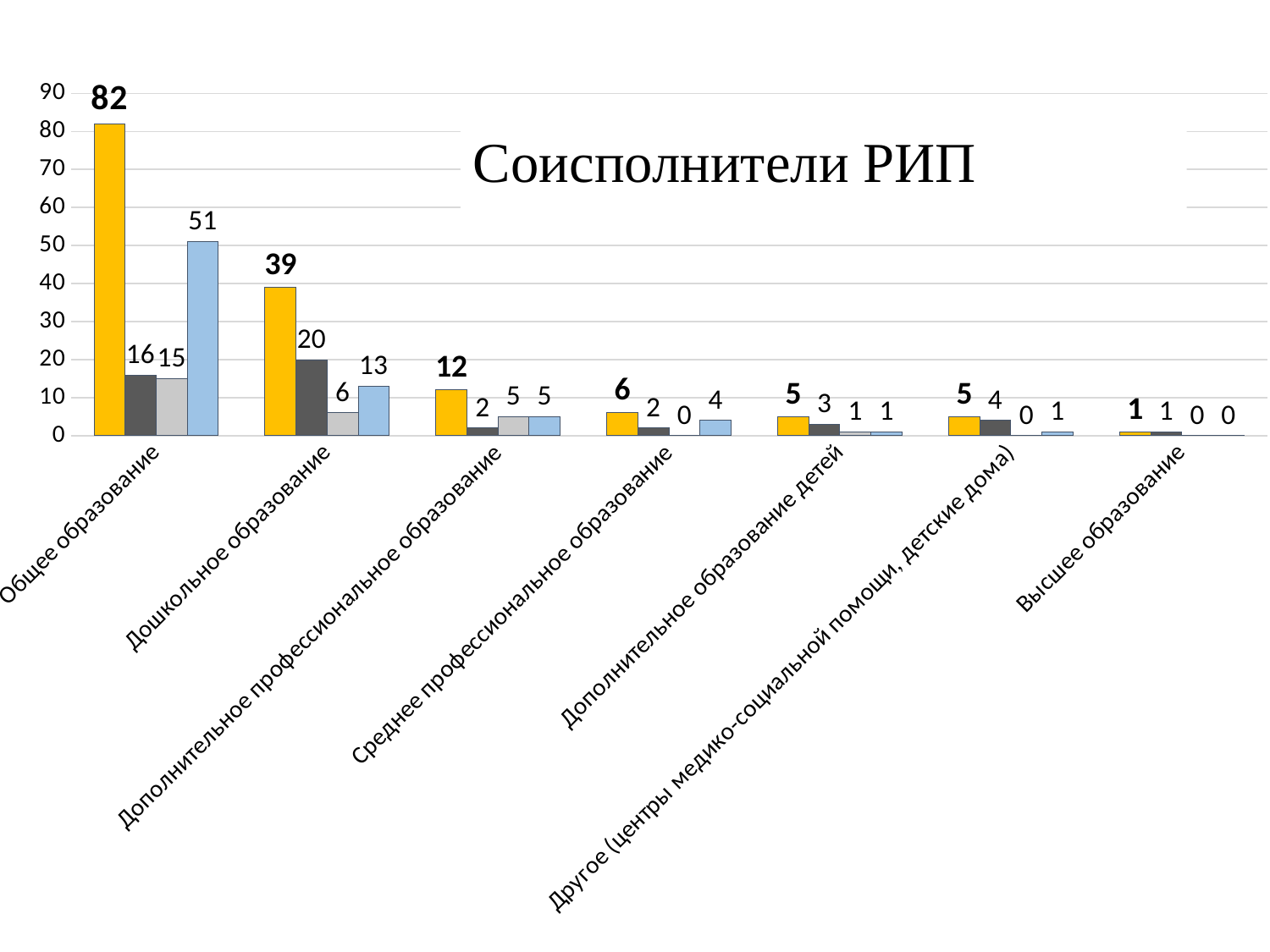
Which category has the lowest yellow bar? Высшее образование Do the yellow bar values rise or fall from left to right along the x axis? fall What is the value of the light blue bar for Среднее профессиональное образование? 4 For Общее образование, which is larger: the dark grey bar or the light blue bar? the light blue bar What is the value of the light blue bar for Дошкольное образование? 13 What kind of chart is shown on the slide? bar chart How many categories are shown on the x axis? 7 What is the value of the yellow bar for Общее образование? 82 What is the title of the chart? Соисполнители РИП What is the value of the dark grey bar for Дополнительное профессиональное образование? 2 What is the difference between the yellow bar values for Общее образование and Дошкольное образование? 43 Which category has the highest yellow bar? Общее образование